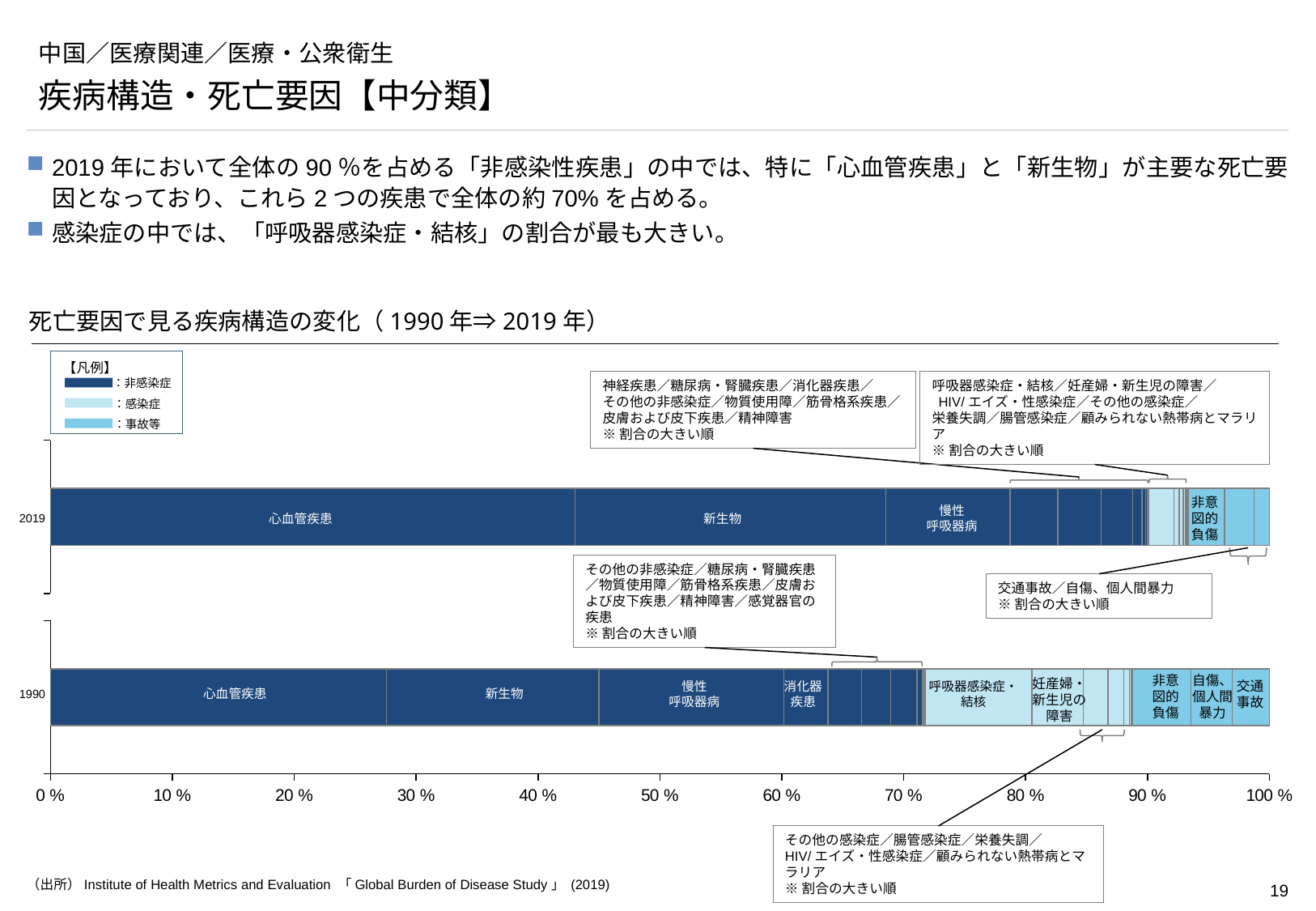
Is the share of 慢性呼吸器病 larger in 2019 or in 1990? 1990 What kind of chart is shown on the slide? Stacked bar chart From 1990 to 2019, did the combined share of 非感染症 (dark blue) rise or fall? rise Is the share of 心血管疾患 larger in 2019 or in 1990? 2019 In the 2019 bar, does the 心血管疾患 segment end at a point greater or less than 40% on the axis? greater Which legend category is shown in dark blue? 非感染症 How many categories does the legend (凡例) list? 3 In the 1990 bar, does the 心血管疾患 segment end at a point greater or less than 30% on the axis? less In the 1990 bar, which cause of death has the largest share? 心血管疾患 How many years (bars) does the chart compare? 2 In the 2019 bar, which cause of death has the largest share? 心血管疾患 What is the title of the chart? 死亡要因で見る疾病構造の変化（1990年⇒2019年）